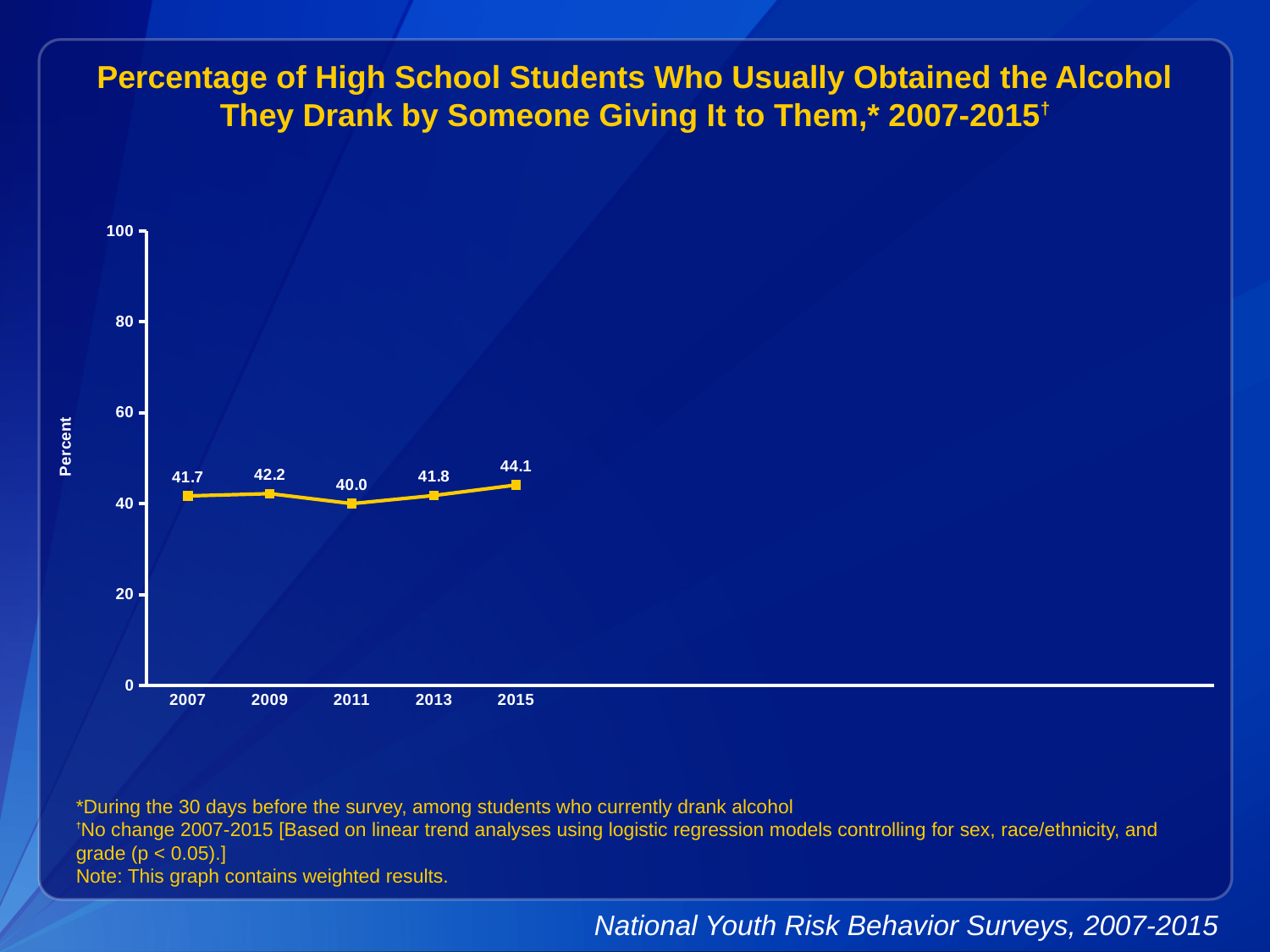
What is the value for 2007? 41.7 What is the value for 2015? 44.1 What is the value for 2011? 40.0 Which year has the highest value? 2015 What kind of chart is shown on the slide? line chart Does the value rise or fall from 2011 to 2015? rise Which is larger, the value for 2009 or the value for 2013? 2009 What is the difference between the values for 2015 and 2011? 4.1 What is the label on the y axis? Percent Is the value for 2013 greater or less than 60? less How many years are plotted on the chart? 5 Which year has the lowest value? 2011